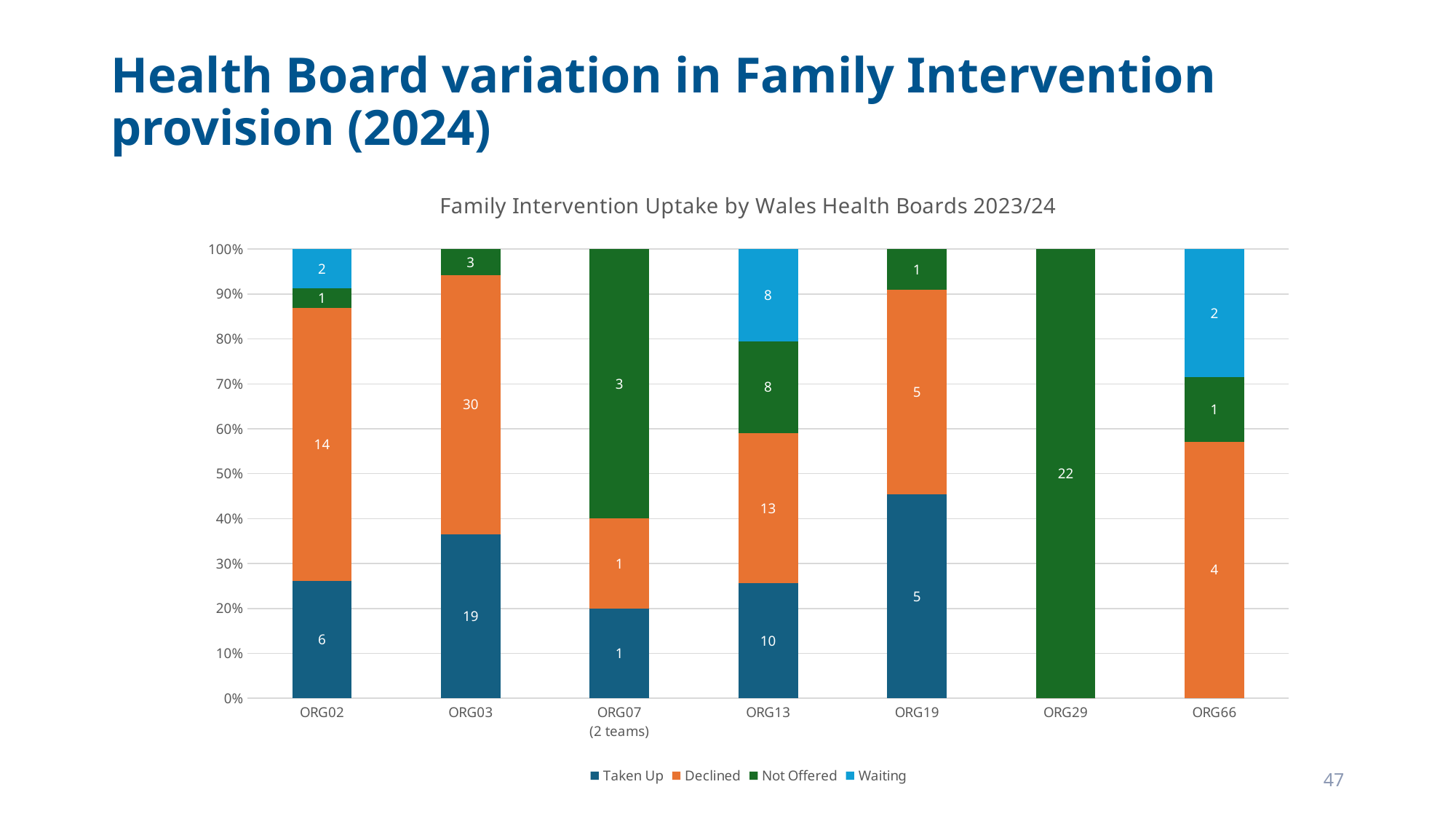
How many series does the legend list? 4 Is the top of the Taken Up segment for ORG19 greater or less than 40%? greater How many health boards are shown on the x axis? 7 What is the Waiting value for ORG66? 2 What is the total of all segments in the ORG02 bar? 23 What is the Declined value for ORG03? 30 What is the Taken Up value for ORG13? 10 Which health board has the highest Taken Up value? ORG03 What is the Not Offered value for ORG29? 22 What is the difference between the Declined and Taken Up values for ORG02? 8 Which health board has the highest Declined value? ORG03 Which is larger, the Not Offered value for ORG13 or the Not Offered value for ORG07 (2 teams)? ORG13